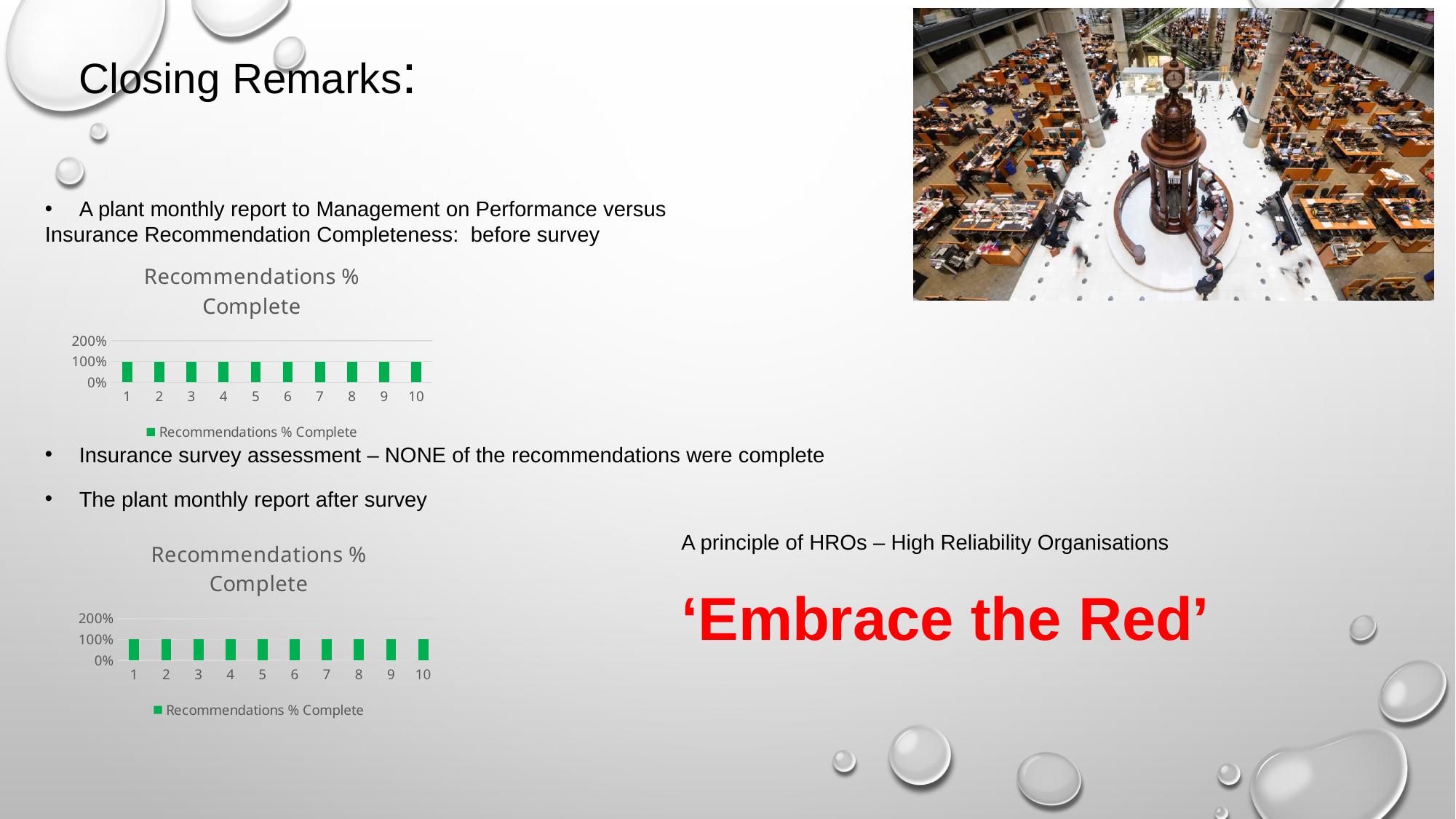
In the lower chart, what is the value for category 10? 100% What kind of chart is the lower chart on the slide? bar chart What is the title of the upper chart? Recommendations % Complete In the lower chart, do the values rise, fall, or stay flat from category 1 to category 10? stay flat How many series does the legend of the lower chart list? 1 In the upper chart, is the value for category 5 greater or less than 200%? less What kind of chart is the upper chart on the slide? bar chart How many categories are shown on the x axis of the lower chart? 10 In the upper chart, what is the value for category 1? 100% What is the legend entry shown below the lower chart? Recommendations % Complete How many categories are shown on the x axis of the upper chart? 10 How many series does the legend of the upper chart list? 1